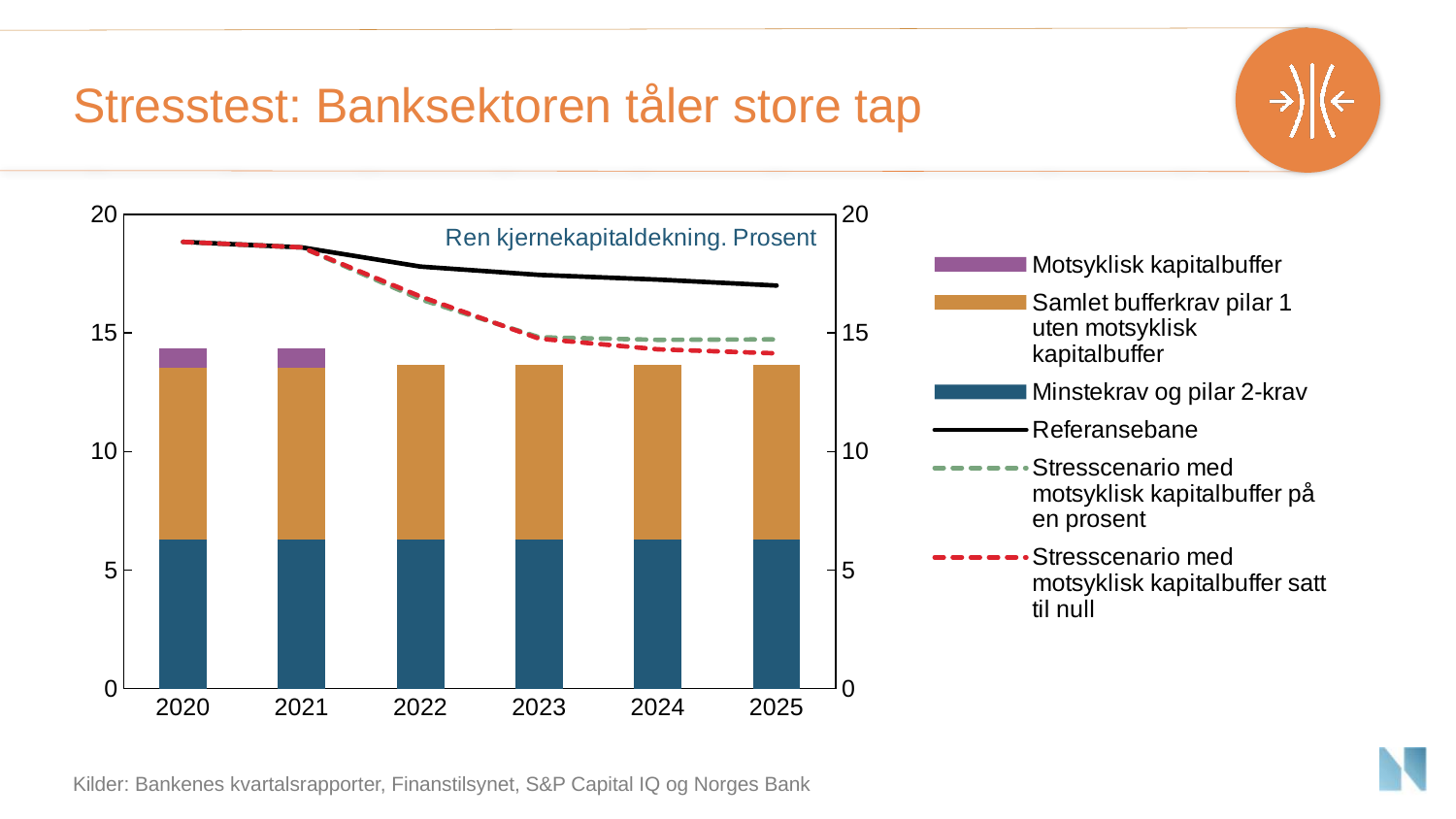
How many years are shown on the x axis of the chart? 6 How many series does the legend list? 6 Is the value of the 'Stresscenario med motsyklisk kapitalbuffer satt til null' line in 2025 greater or less than 15? less In which years does the Motsyklisk kapitalbuffer segment appear in the stacked bars? 2020 and 2021 Is the Minstekrav og pilar 2-krav segment of the 2022 bar greater or less than 5? greater Does the Referansebane line rise or fall from 2020 to 2025? Fall Which colour represents Motsyklisk kapitalbuffer in the legend? Purple Is the value of the Referansebane line in 2025 greater or less than 15? greater What kind of chart is shown on the slide? A stacked bar chart with line series In 2025, which is larger: the Referansebane line or the 'Stresscenario med motsyklisk kapitalbuffer satt til null' line? Referansebane What is the title printed inside the chart area? Ren kjernekapitaldekning. Prosent